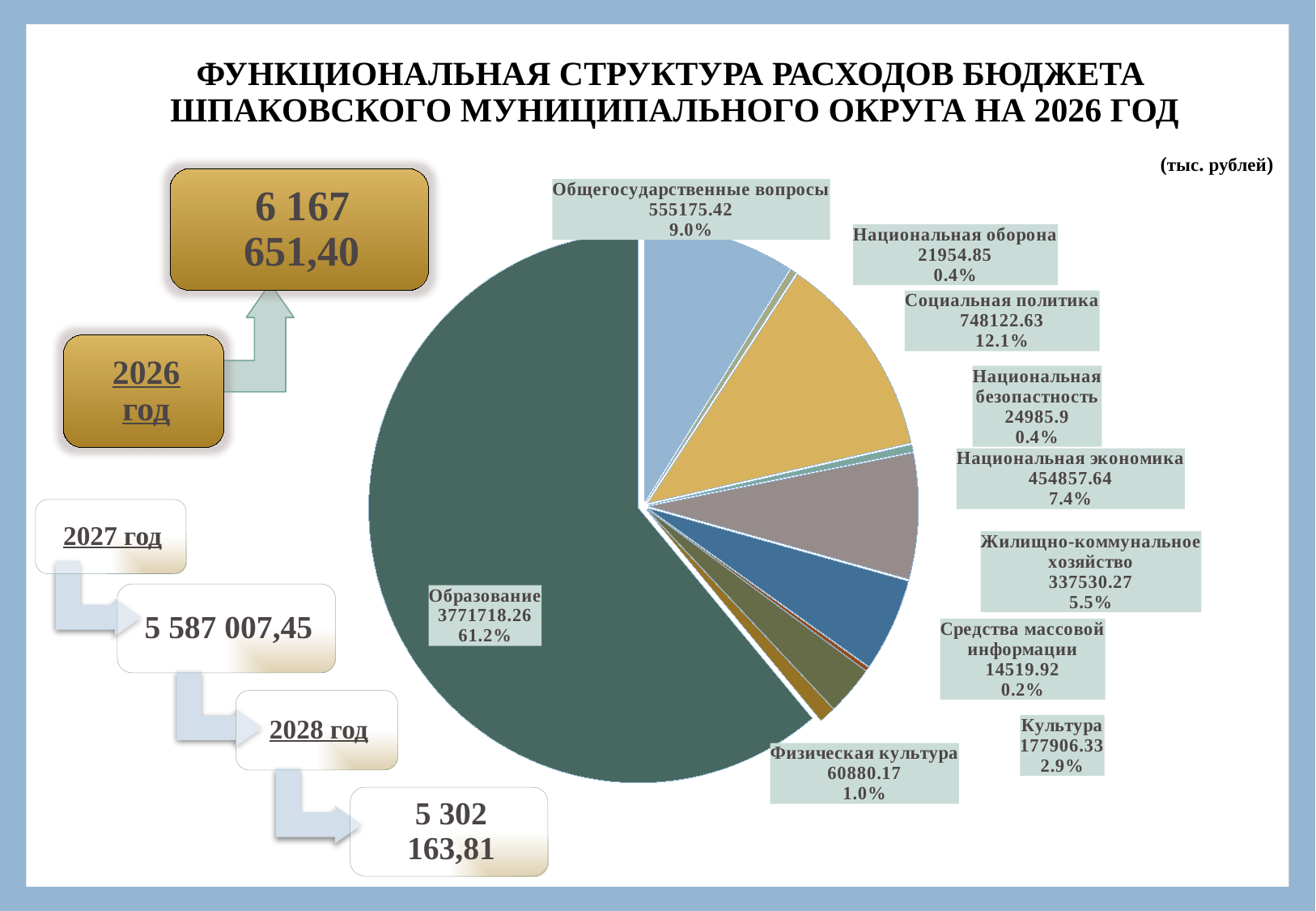
In what units are the values on the slide given? тыс. рублей What is the difference between the values for Социальная политика and Общегосударственные вопросы? 192947.21 How many categories (slices) does the pie chart show? 10 What share of the pie does Образование account for? 61.2% What share of the pie does Национальная экономика account for? 7.4% What is the value for Социальная политика in the pie chart? 748122.63 Which is larger in the pie chart: Культура or Физическая культура? Культура Which category has the smallest slice in the pie chart? Средства массовой информации What is the value for Образование in the pie chart? 3771718.26 Which category has the largest slice in the pie chart? Образование What is the value for Жилищно-коммунальное хозяйство in the pie chart? 337530.27 What kind of chart is shown on the slide? Pie chart